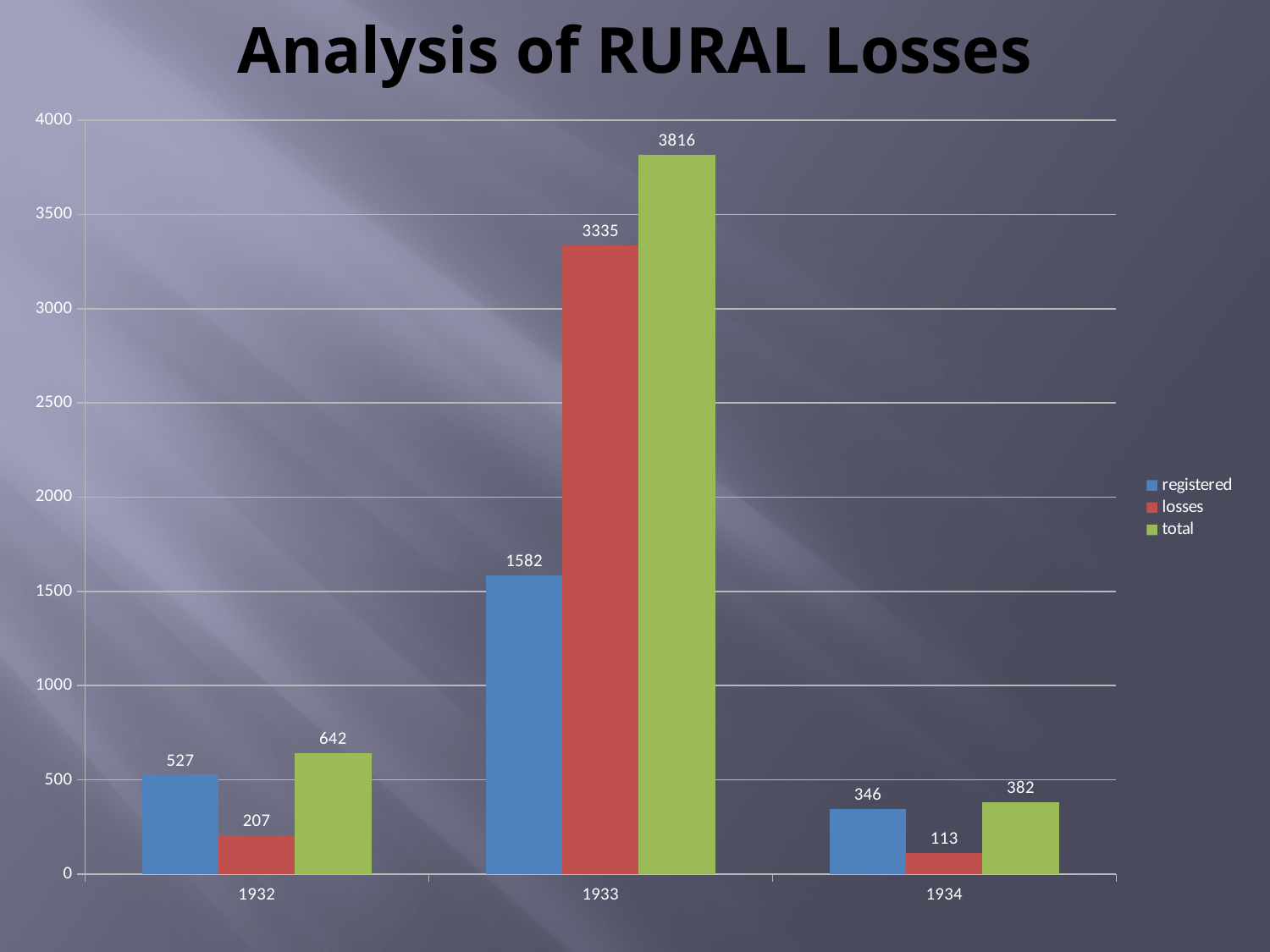
What is the value for 'registered' in 1933? 1582 How many years are shown on the x axis? 3 Is the value for 'losses' in 1933 greater or less than 3000? greater What kind of chart is shown on the slide? bar chart Which year has the lowest 'losses' value? 1934 How many series does the legend list? 3 What is the difference between the 'total' and 'registered' values in 1933? 2234 What is the value for 'total' in 1932? 642 Which is larger in 1932: 'registered' or 'losses'? registered What is the value for 'losses' in 1934? 113 What is the title of the chart? Analysis of RURAL Losses Which year has the highest 'total' value? 1933